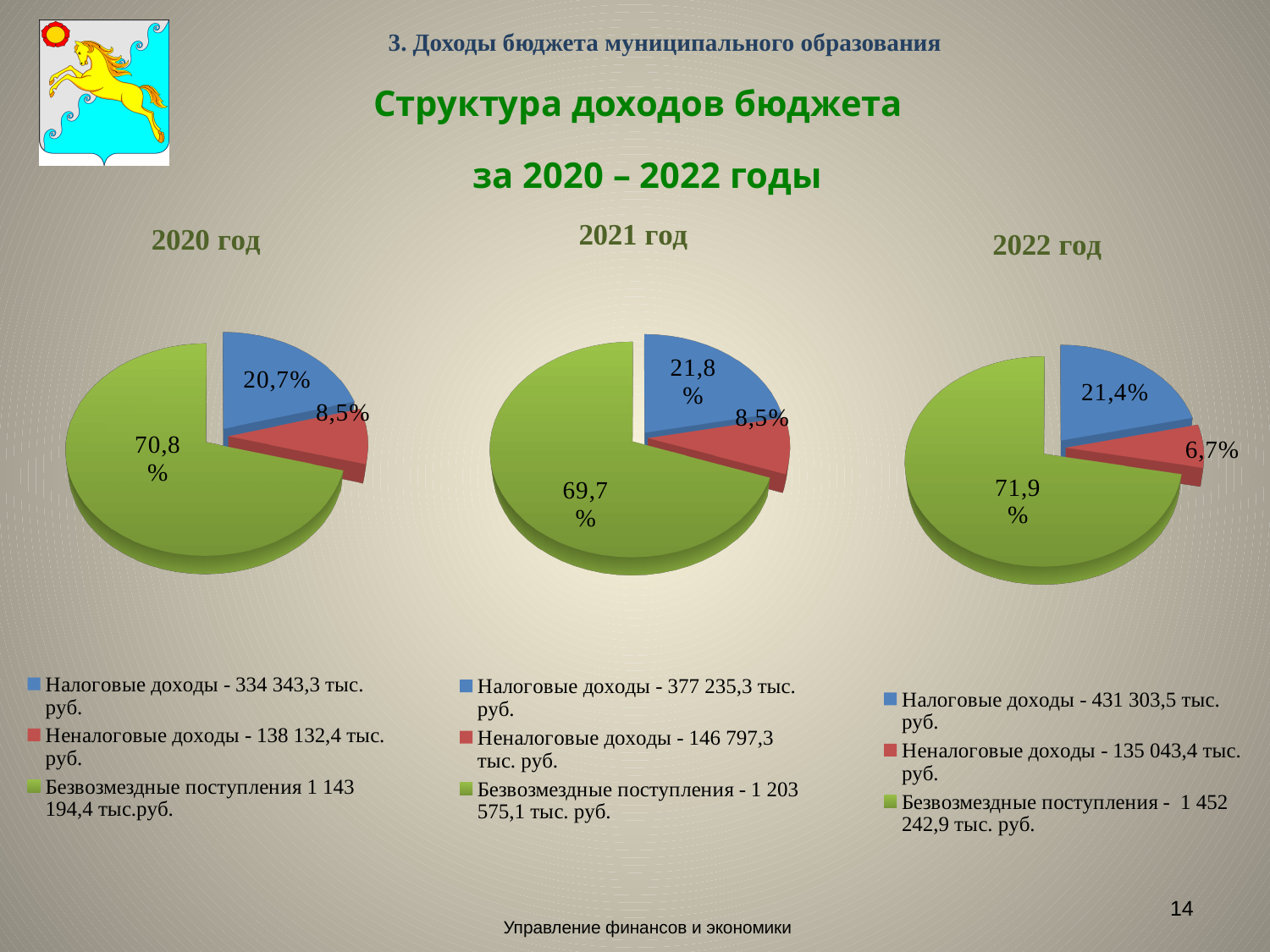
How many charts are shown on the slide? 3 According to the legend of the 2020 год chart, what is the amount of Налоговые доходы? 334 343,3 тыс. руб. According to the legend of the 2022 год chart, what is the amount of Безвозмездные поступления? 1 452 242,9 тыс. руб. How many slices does the 2021 год pie chart have? 3 In the 2022 год pie chart, what share is Неналоговые доходы? 6,7% In the 2022 год pie chart, which category has the largest share? Безвозмездные поступления In the 2020 год pie chart, which category has the smallest share? Неналоговые доходы In the 2020 год pie chart, what share of the budget revenue is Безвозмездные поступления? 70,8% In the 2021 год pie chart, what share is Налоговые доходы? 21,8% What type of chart is used for 2020 год? Pie chart In the 2021 год pie chart, what is the difference in percentage points between Безвозмездные поступления and Налоговые доходы? 47,9 Which is larger in the 2022 год pie chart: the share of Налоговые доходы or the share of Неналоговые доходы? Налоговые доходы